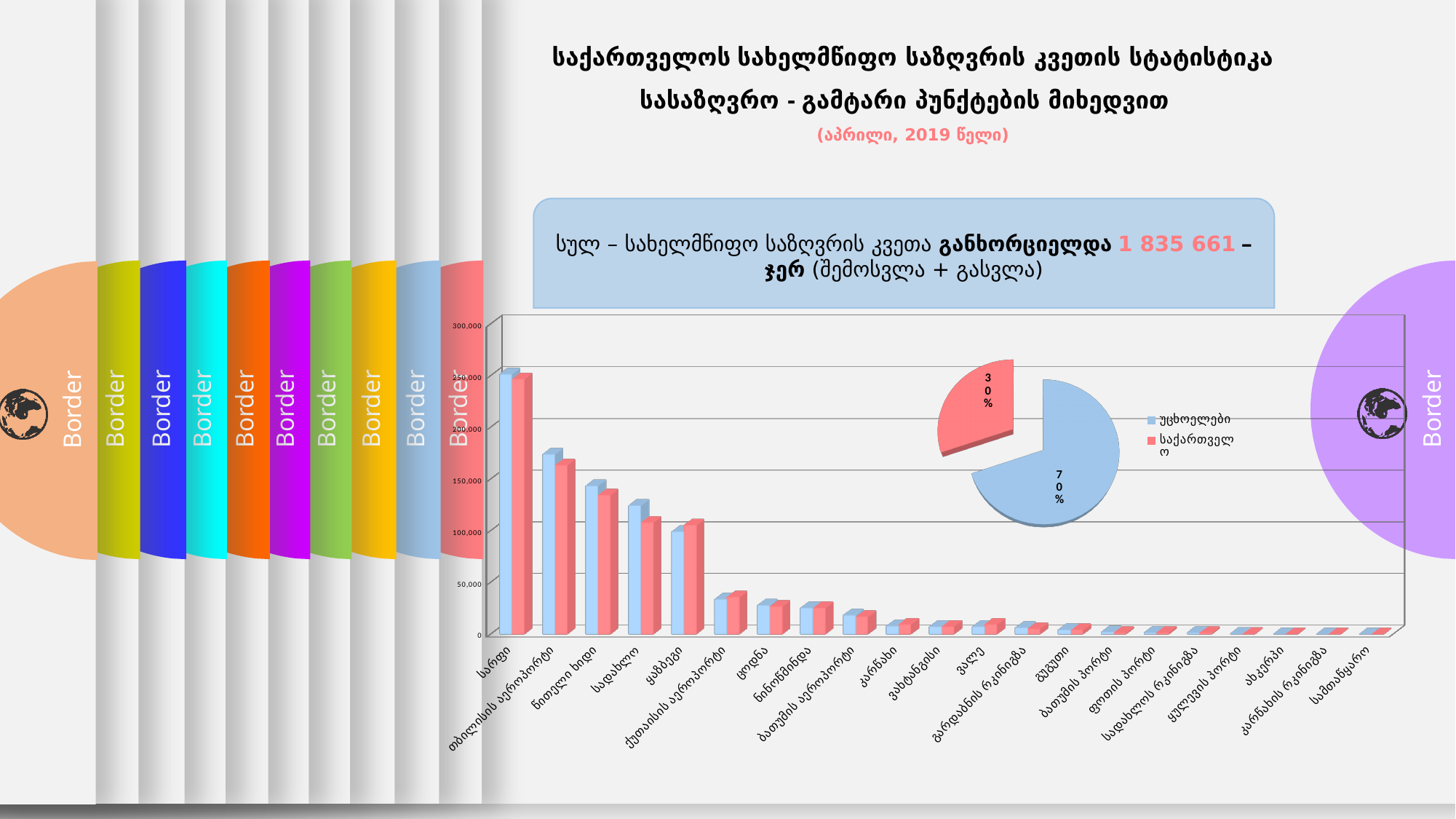
In the pie chart, what share does უცხოელები have? 70% In the bar chart, which category has the highest values? სარფი In the bar chart, are the values for ქუთაისის აეროპორტი greater or less than 50,000? less In the bar chart, do the values generally rise or fall moving from left to right along the x axis? fall How many categories are shown on the x axis of the bar chart? 21 How many entries does the legend of the pie chart list? 2 In the pie chart, which slice is larger, უცხოელები or საქართველო? უცხოელები In the bar chart, which category has larger values, თბილისის აეროპორტი or წითელი ხიდი? თბილისის აეროპორტი In the bar chart, are the values for სარფი greater or less than 200,000? greater What type of chart is the large chart at the bottom of the slide? bar chart In the pie chart, what share does საქართველო have? 30% What type of chart is the small chart on the right showing 70% and 30%? pie chart